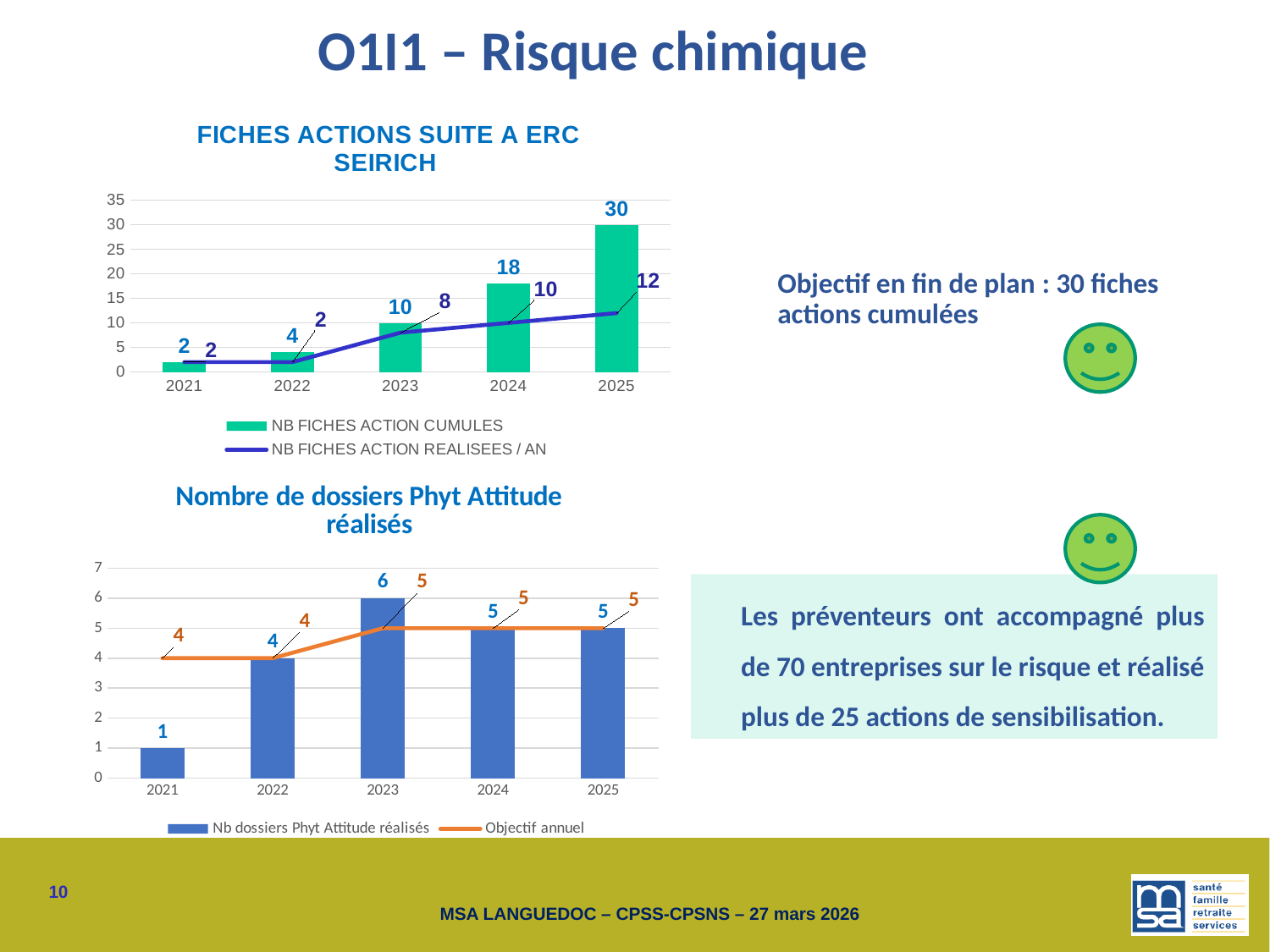
In the chart 'FICHES ACTIONS SUITE A ERC SEIRICH', what is the value of NB FICHES ACTION CUMULES for 2025? 30 In the chart 'FICHES ACTIONS SUITE A ERC SEIRICH', what is the difference between NB FICHES ACTION CUMULES in 2024 and in 2023? 8 What kind of chart is 'Nombre de dossiers Phyt Attitude réalisés'? bar chart with a line In the chart 'Nombre de dossiers Phyt Attitude réalisés', what is the value of Nb dossiers Phyt Attitude réalisés for 2023? 6 In the chart 'Nombre de dossiers Phyt Attitude réalisés', what is the Objectif annuel for 2022? 4 In the chart 'FICHES ACTIONS SUITE A ERC SEIRICH', do the NB FICHES ACTION CUMULES values rise or fall from 2021 to 2025? rise In the chart 'Nombre de dossiers Phyt Attitude réalisés', how many years are shown on the x axis? 5 In the chart 'FICHES ACTIONS SUITE A ERC SEIRICH', what is the value of NB FICHES ACTION REALISEES / AN for 2023? 8 In the chart 'Nombre de dossiers Phyt Attitude réalisés', which is larger in 2023: Nb dossiers Phyt Attitude réalisés or Objectif annuel? Nb dossiers Phyt Attitude réalisés In the chart 'FICHES ACTIONS SUITE A ERC SEIRICH', how many series does the legend list? 2 In the chart 'Nombre de dossiers Phyt Attitude réalisés', which year has the lowest value of Nb dossiers Phyt Attitude réalisés? 2021 In the chart 'FICHES ACTIONS SUITE A ERC SEIRICH', which year has the highest value of NB FICHES ACTION CUMULES? 2025